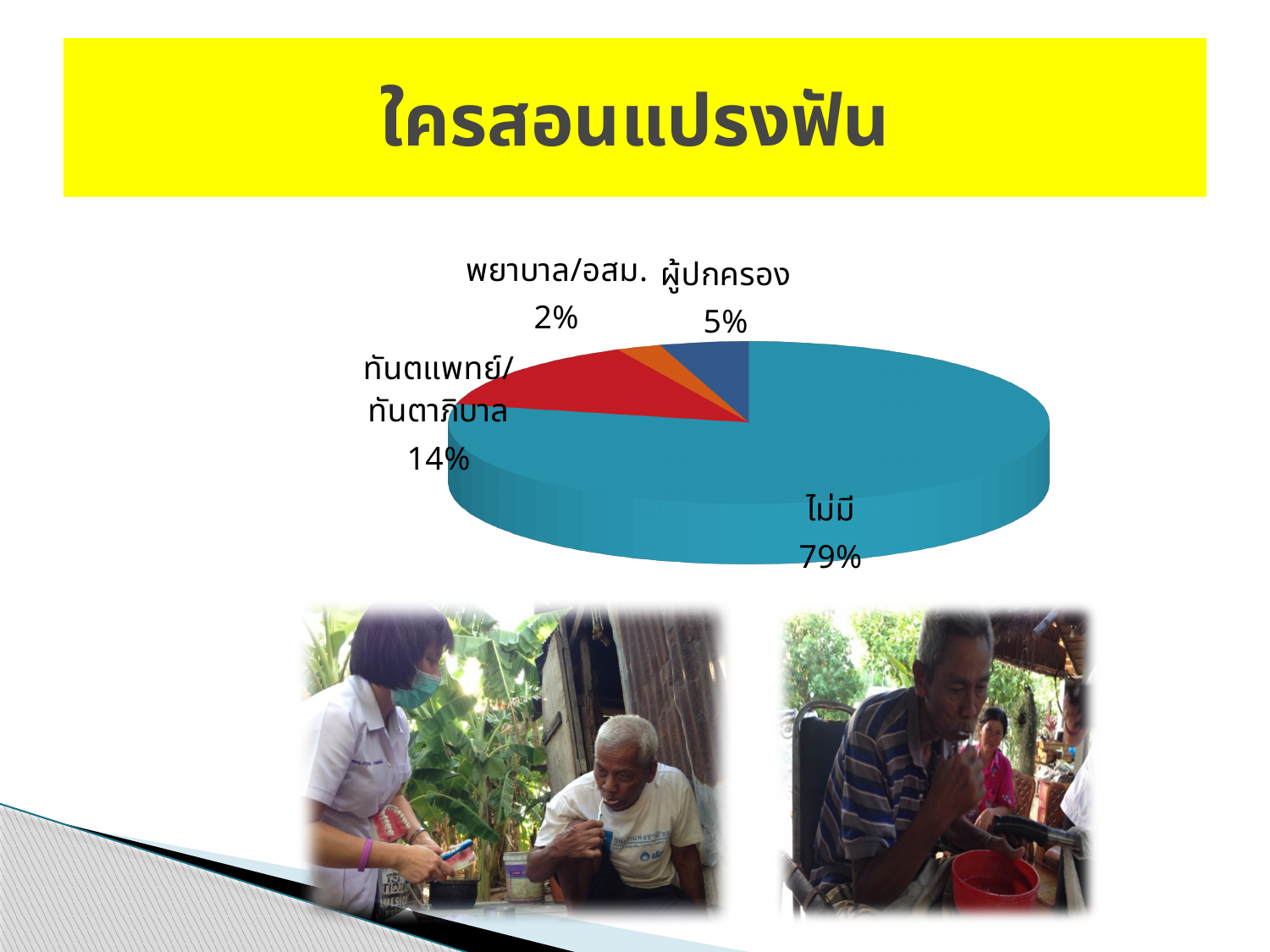
What colour is the largest slice of the pie chart? Teal blue What percentage is shown for the ทันตแพทย์/ทันตาภิบาล slice? 14% Which is larger, the ผู้ปกครอง slice or the พยาบาล/อสม. slice? ผู้ปกครอง What percentage is shown for the ไม่มี slice? 79% What percentage is shown for the ผู้ปกครอง slice? 5% What kind of chart is shown on the slide? Pie chart How many slices does the pie chart have? 4 Which category has the smallest share of the pie? พยาบาล/อสม. Which category has the largest share of the pie? ไม่มี What is the title of the slide above the chart? ใครสอนแปรงฟัน What is the difference in percentage points between the ไม่มี slice and the ทันตแพทย์/ทันตาภิบาล slice? 65 What percentage is shown for the พยาบาล/อสม. slice? 2%